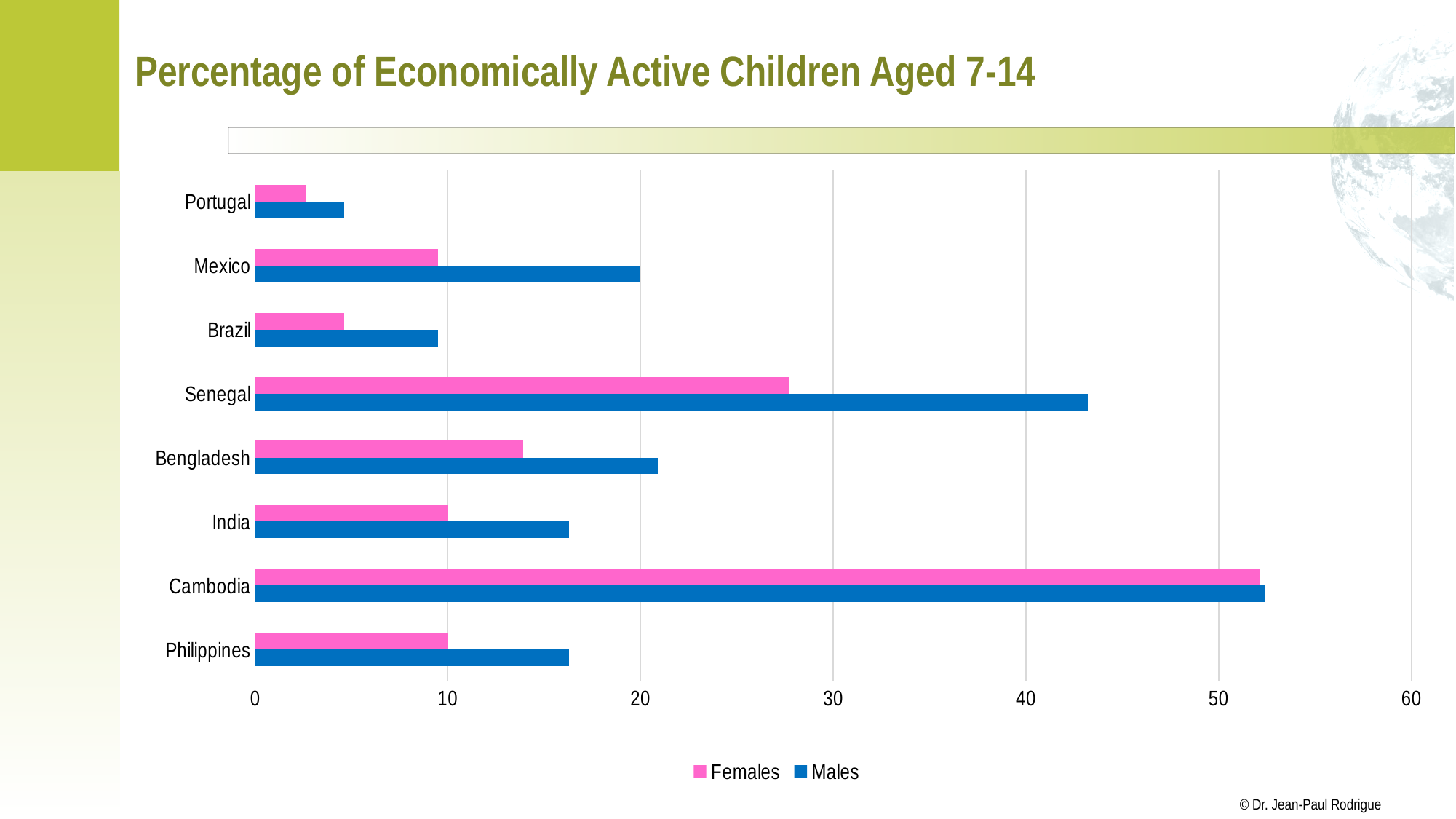
How many countries are shown on the chart? 8 Which country has the highest value for Females? Cambodia Which is larger: the Males value for Senegal or the Males value for Mexico? Senegal What type of chart is shown on the slide? bar chart Is the value for Males in Senegal greater or less than 40? greater Which country has the highest value for Males? Cambodia Which colour represents Females in the chart? pink Which country has the lowest value for Females? Portugal How many series does the legend list? 2 Is the value for Females in Cambodia greater or less than 50? greater Which country has the lowest value for Males? Portugal